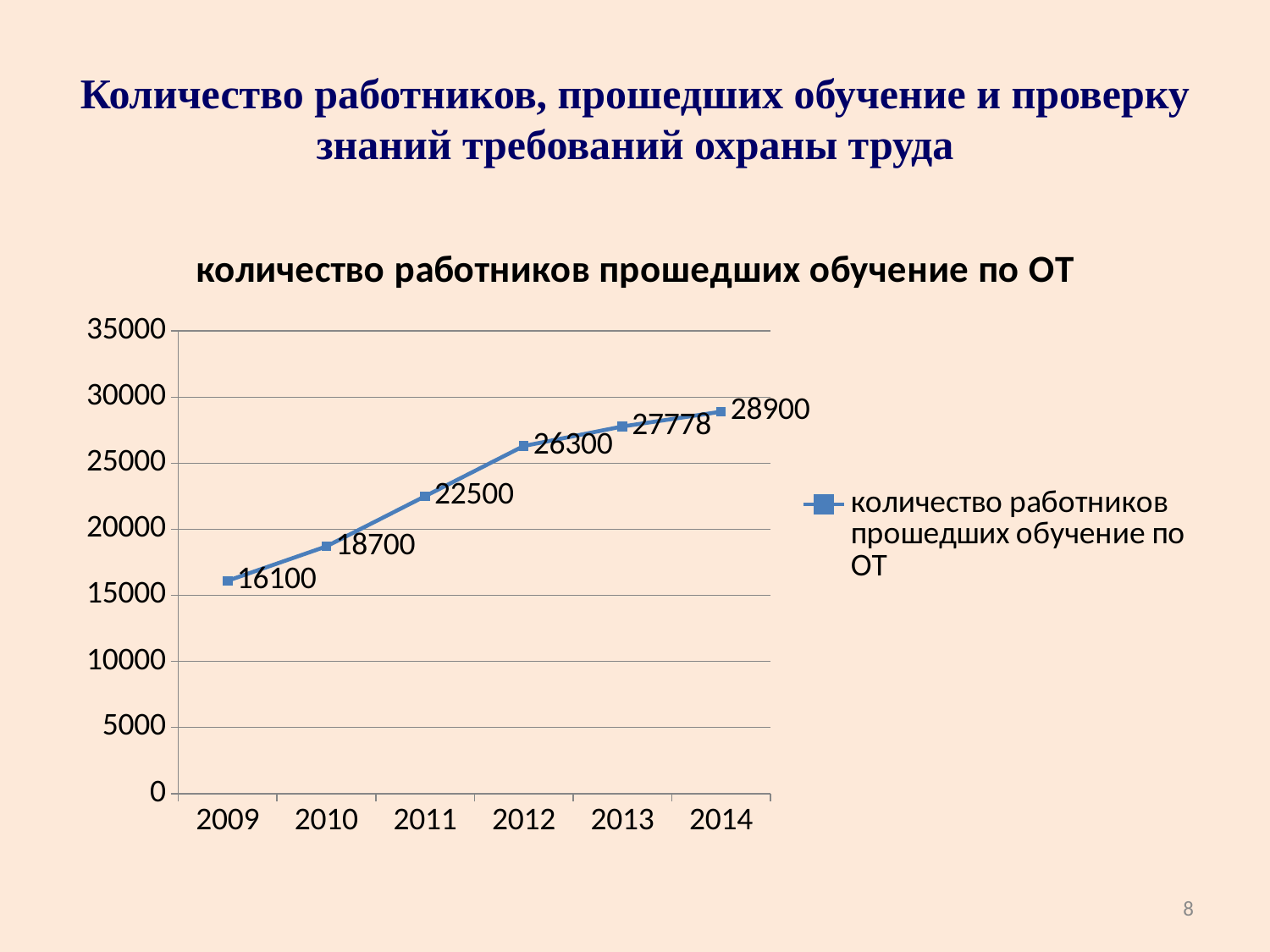
Is the value for 2010 greater or less than 20000? less Which year has the lowest value? 2009 Do the values rise or fall from 2009 to 2014? rise What is the value for 2009? 16100 What is the value for 2012? 26300 How many years are plotted on the x axis? 6 What is the difference between the values for 2014 and 2009? 12800 What kind of chart is shown? line chart Which is larger, the value for 2011 or the value for 2013? 2013 What is the difference between the values for 2011 and 2010? 3800 Which year has the highest value? 2014 What is the value for 2013? 27778